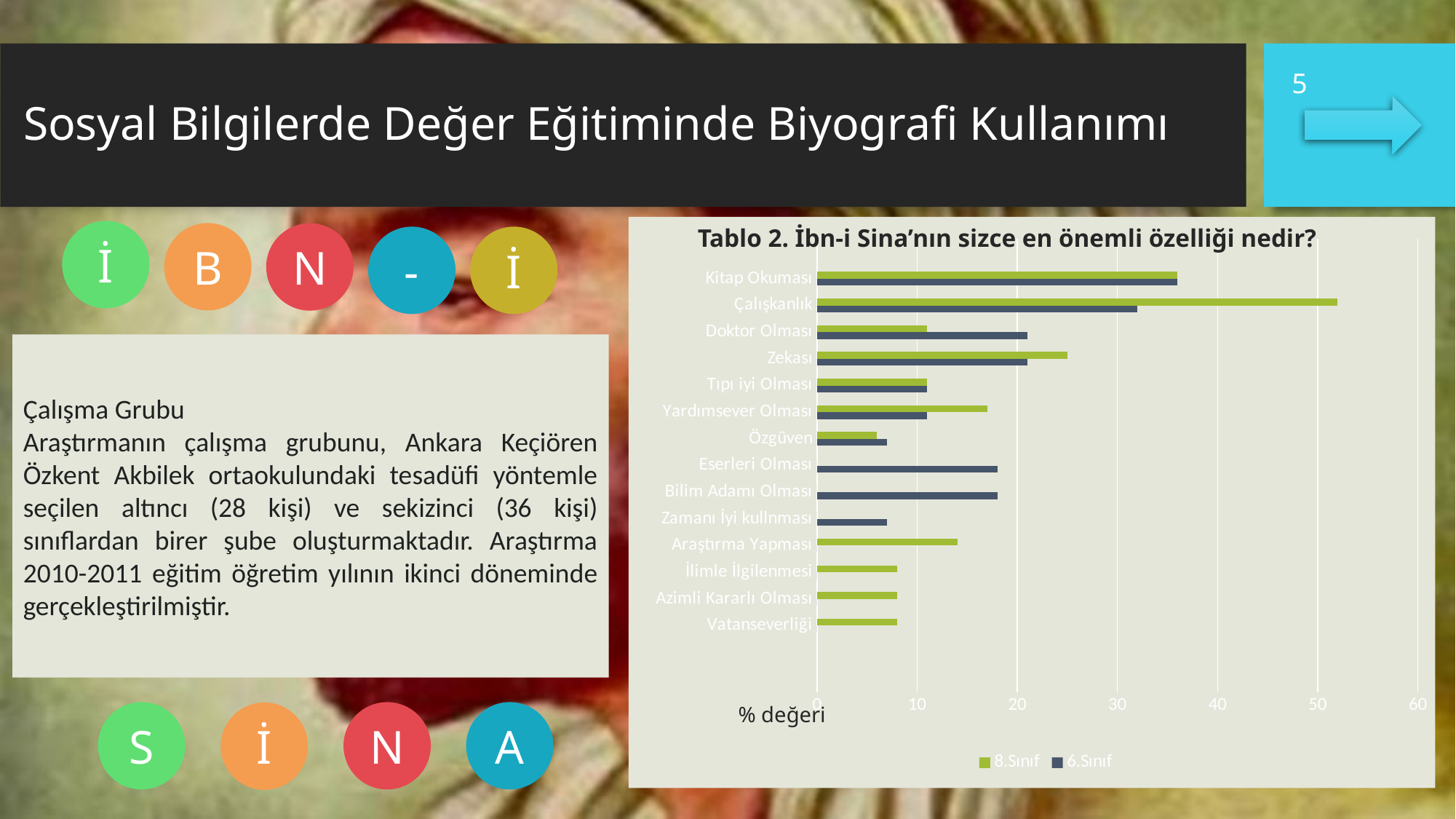
What label is shown on the horizontal axis of the chart? % değeri Is the 8.Sınıf value for Çalışkanlık greater or less than 40? greater How many categories are shown on the vertical axis of the chart? 14 How many series does the legend of the chart list? 2 Which category has the highest value for the 8.Sınıf series? Çalışkanlık Is the 8.Sınıf value for Özgüven greater or less than 10? less Is the 8.Sınıf value for Kitap Okuması greater or less than 30? greater What kind of chart is shown on the slide? bar chart What is the title of the chart? Tablo 2. İbn-i Sina'nın sizce en önemli özelliği nedir? For Yardımsever Olması, which series has the larger value, 8.Sınıf or 6.Sınıf? 8.Sınıf For Doktor Olması, which series has the larger value, 8.Sınıf or 6.Sınıf? 6.Sınıf Which category has the highest value for the 6.Sınıf series? Kitap Okuması